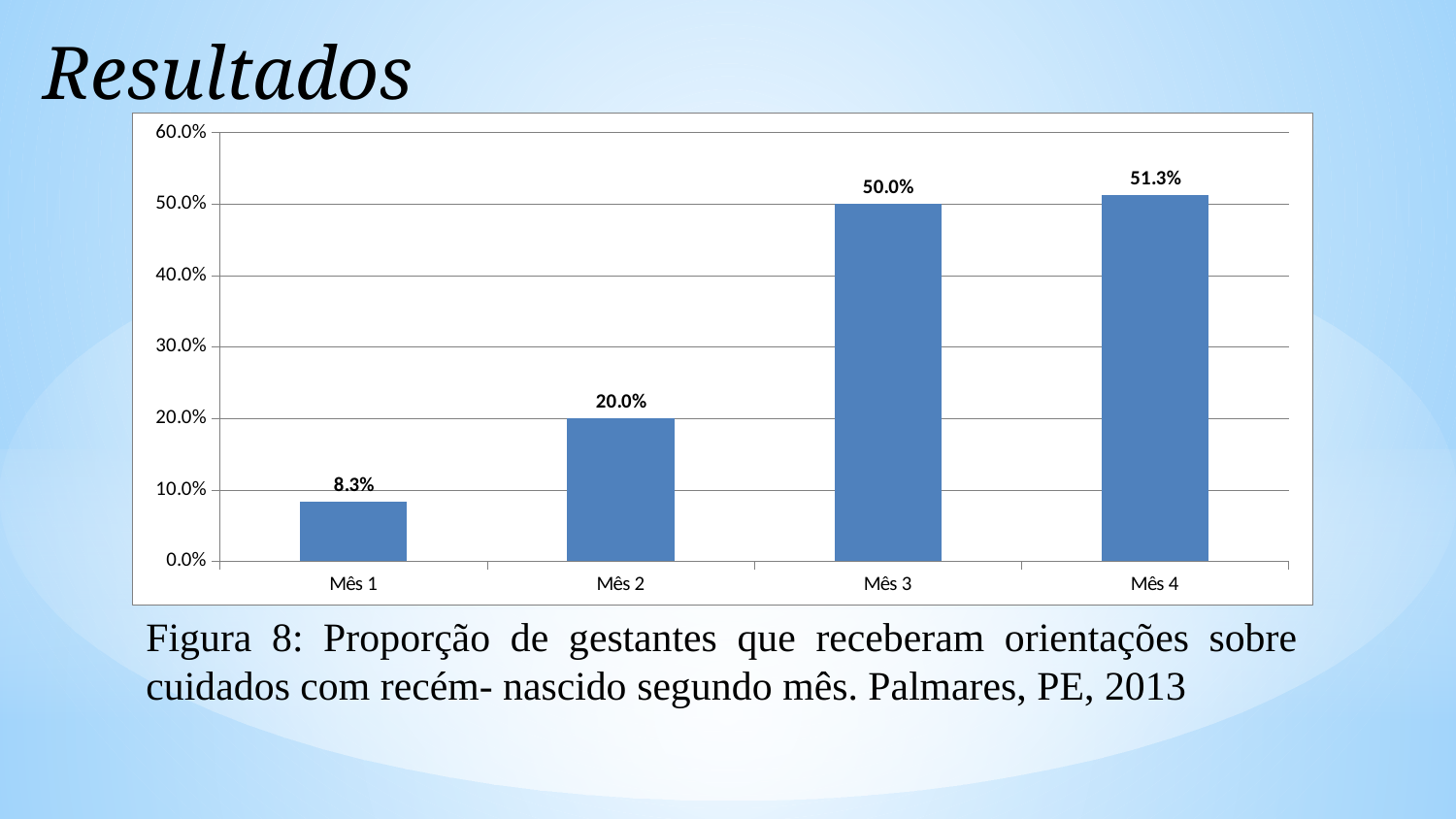
What is the difference between the values for Mês 4 and Mês 1? 43.0% What is the value for Mês 2? 20.0% Which month has the highest value? Mês 4 What is the value for Mês 4? 51.3% Which is larger, the value for Mês 2 or the value for Mês 3? Mês 3 What is the value for Mês 1? 8.3% What is the value for Mês 3? 50.0% How many months are shown on the x axis? 4 What kind of chart is shown on the slide? Bar chart Which month has the lowest value? Mês 1 Do the values rise or fall from Mês 1 to Mês 4? Rise What is the difference between the values for Mês 3 and Mês 2? 30.0%